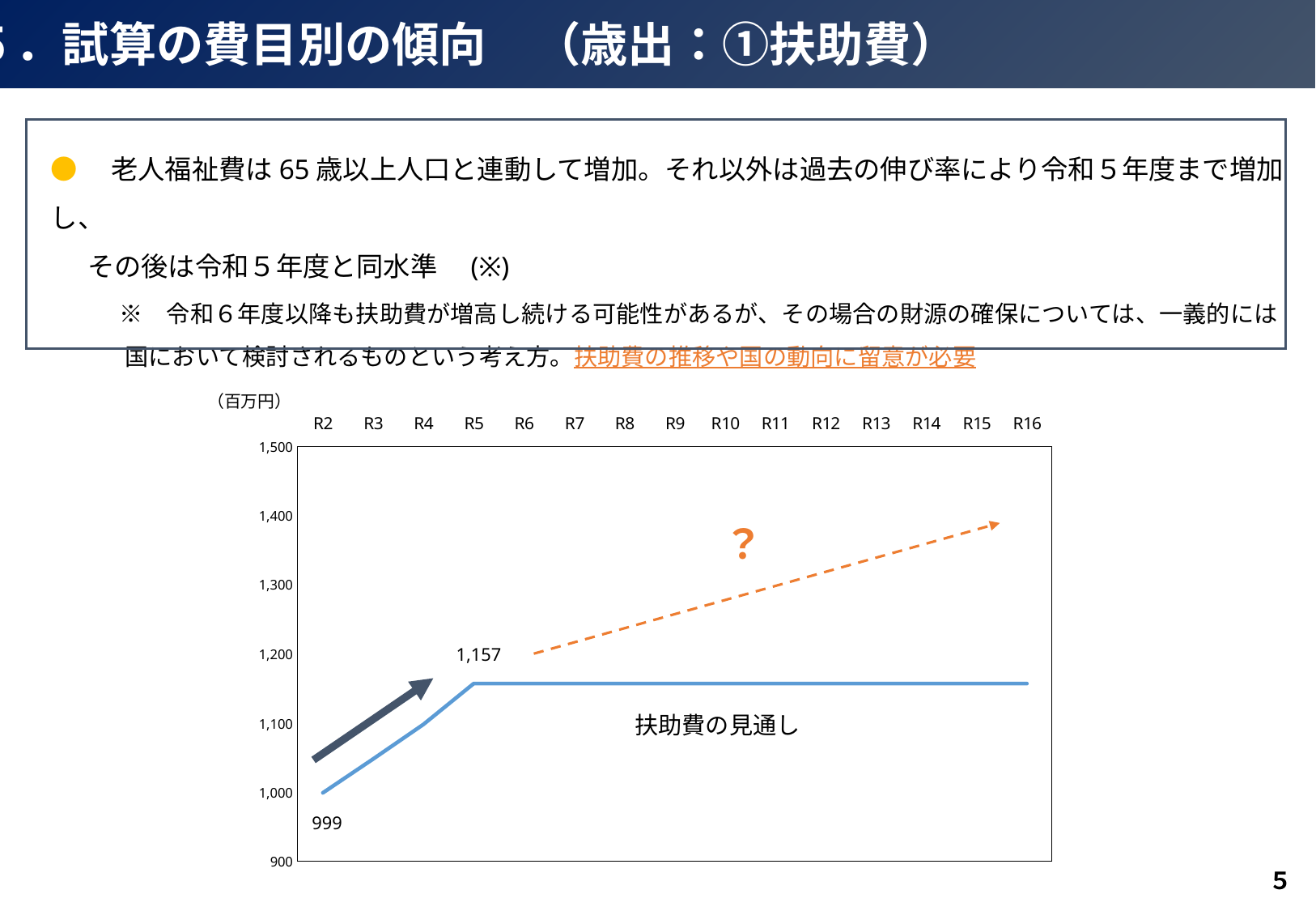
Is the value for R3 greater or less than 1,100? less Do the values rise or fall from R2 to R5? rise What is the value for R5 on the chart? 1,157 Do the values change from R5 to R16? No, they stay flat How many years are shown on the x axis? 15 What is the value for R2 on the chart? 999 Which year on the x axis has the lowest value? R2 What kind of chart is shown on the slide? line chart What is the difference between the values for R5 and R2? 158 Is the value for R10 greater or less than 1,200? less What unit is shown above the y axis of the chart? 百万円 Which is larger, the value for R2 or the value for R5? R5